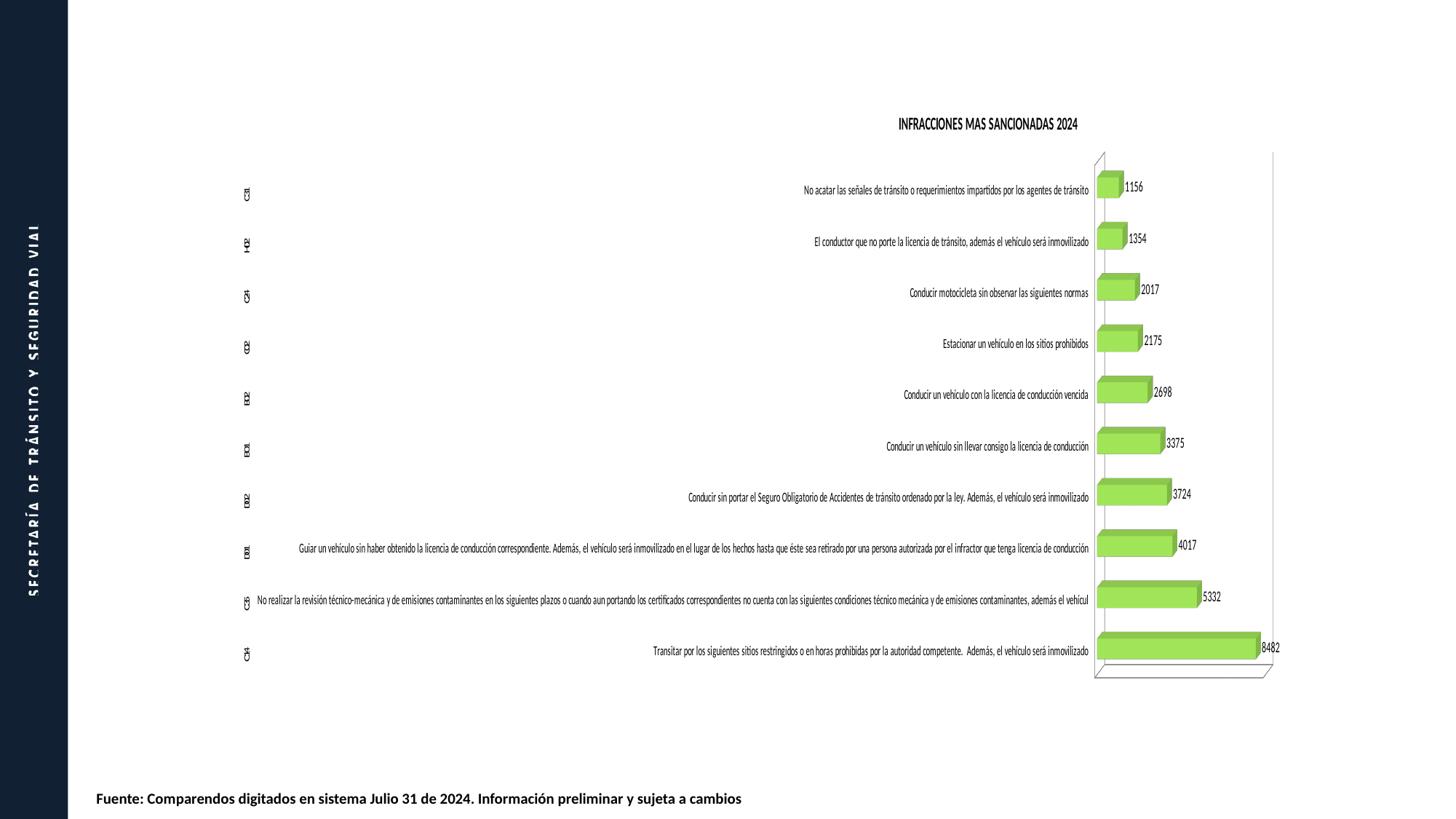
Which is larger: the value for "Conducir sin portar el Seguro Obligatorio de Accidentes de tránsito..." or "Guiar un vehículo sin haber obtenido la licencia de conducción correspondiente..."? Guiar un vehículo sin haber obtenido la licencia de conducción correspondiente... What is the difference between the value for "Transitar por los siguientes sitios restringidos..." (8482) and "No realizar la revisión técnico-mecánica..." (5332)? 3150 What is the value for "Estacionar un vehículo en los sitios prohibidos"? 2175 Which infraction has the highest value? Transitar por los siguientes sitios restringidos o en horas prohibidas por la autoridad competente. Además, el vehículo será inmovilizado What is the value for "El conductor que no porte la licencia de tránsito, además el vehículo será inmovilizado"? 1354 How many infraction categories are shown in the chart? 10 What is the difference between the value for "Conducir un vehículo con la licencia de conducción vencida" and "Estacionar un vehículo en los sitios prohibidos"? 523 Which infraction has the lowest value? No acatar las señales de tránsito o requerimientos impartidos por los agentes de tránsito What is the value for "Conducir un vehículo sin llevar consigo la licencia de conducción"? 3375 What is the value for "Conducir motocicleta sin observar las siguientes normas"? 2017 What is the title of the chart? INFRACCIONES MAS SANCIONADAS 2024 What kind of chart is shown on the slide? Bar chart